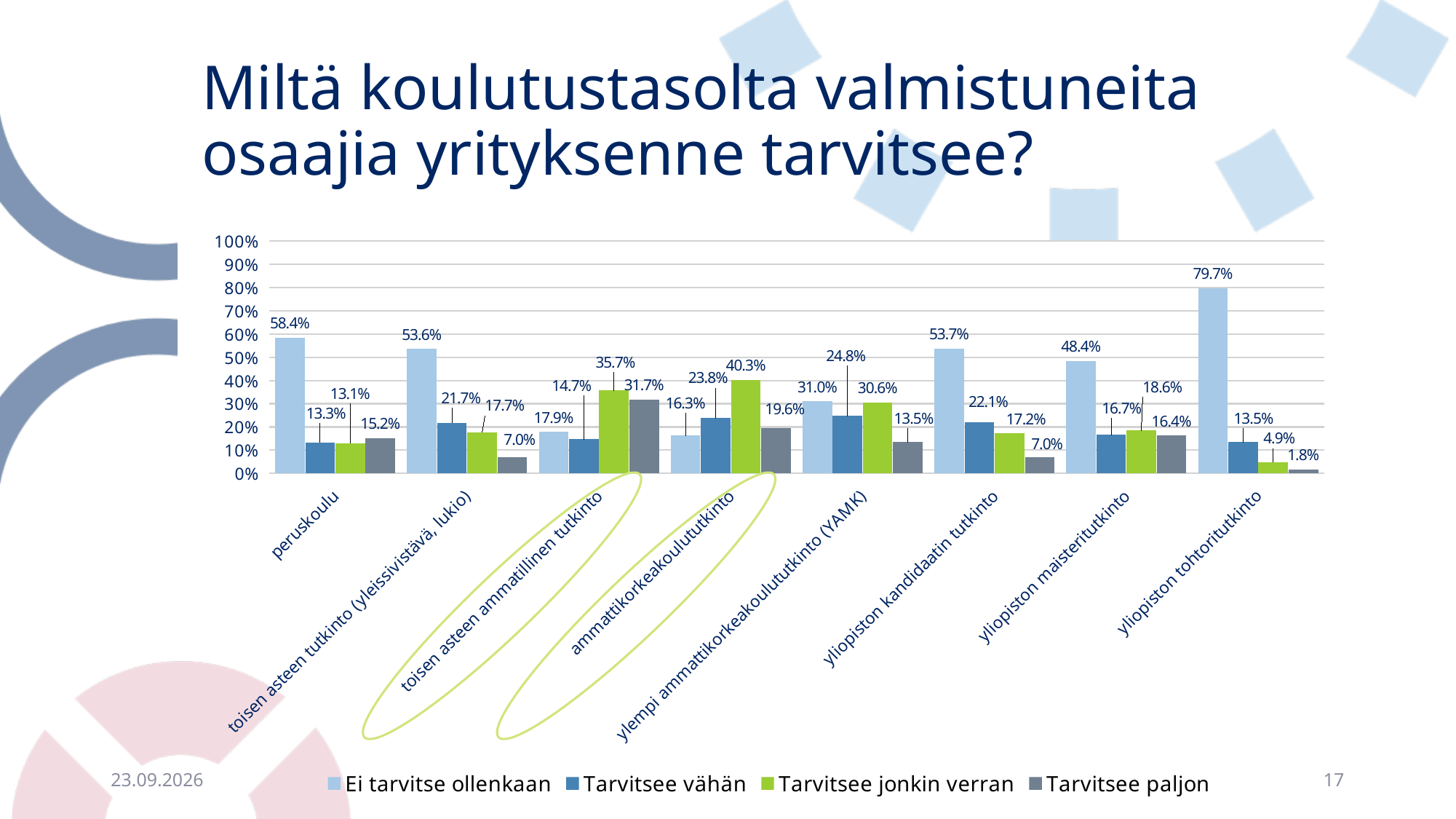
How many series does the legend list? 4 How many education-level categories are shown on the x axis? 8 What is the difference between the "Ei tarvitse ollenkaan" values for yliopiston tohtoritutkinto and peruskoulu? 21.3% What is the value of "Tarvitsee paljon" for toisen asteen ammatillinen tutkinto? 31.7% What is the value of "Tarvitsee jonkin verran" for ammattikorkeakoulututkinto? 40.3% What is the value of "Tarvitsee vähän" for ylempi ammattikorkeakoulututkinto (YAMK)? 24.8% Which category has the lowest value for "Tarvitsee paljon"? yliopiston tohtoritutkinto Which legend entry is shown in green? Tarvitsee jonkin verran Which is larger: "Tarvitsee jonkin verran" for ammattikorkeakoulututkinto or for toisen asteen ammatillinen tutkinto? ammattikorkeakoulututkinto Which category has the highest value for "Ei tarvitse ollenkaan"? yliopiston tohtoritutkinto What is the value of "Ei tarvitse ollenkaan" for yliopiston tohtoritutkinto? 79.7% What kind of chart is shown on the slide? bar chart